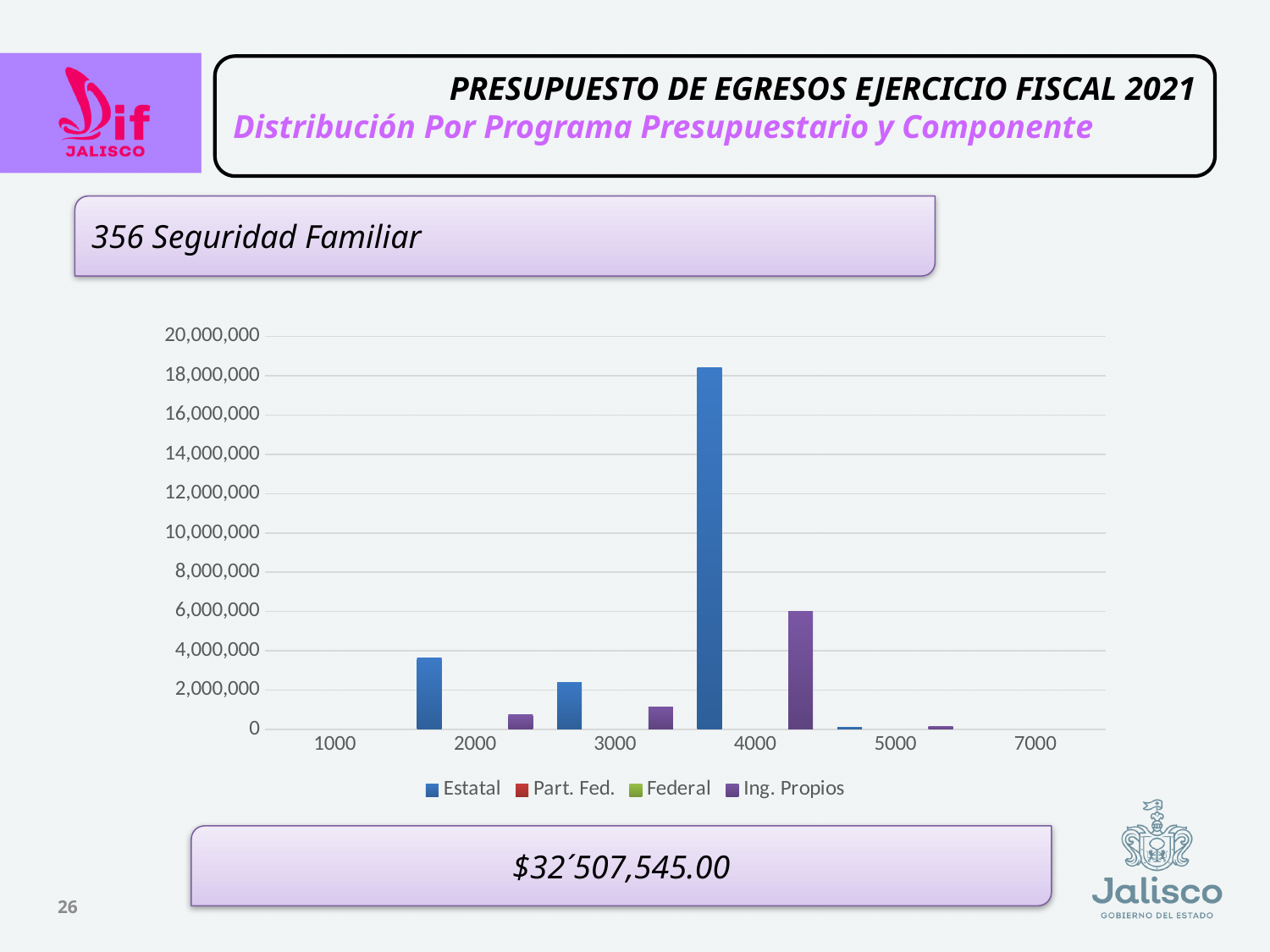
Is the Ing. Propios value for category 4000 greater or less than 4,000,000? greater Is the Estatal value for category 4000 greater or less than 16,000,000? greater Is the Estatal value for category 3000 greater or less than 2,000,000? greater How many categories are shown on the x axis of the chart? 6 Which category has the larger Estatal value, 2000 or 3000? 2000 What kind of chart is shown on the slide? bar chart How many series does the chart legend list? 4 For category 4000, which series has the larger value, Estatal or Ing. Propios? Estatal What is the name of the program shown above the chart? 356 Seguridad Familiar Which category has the highest Estatal bar? 4000